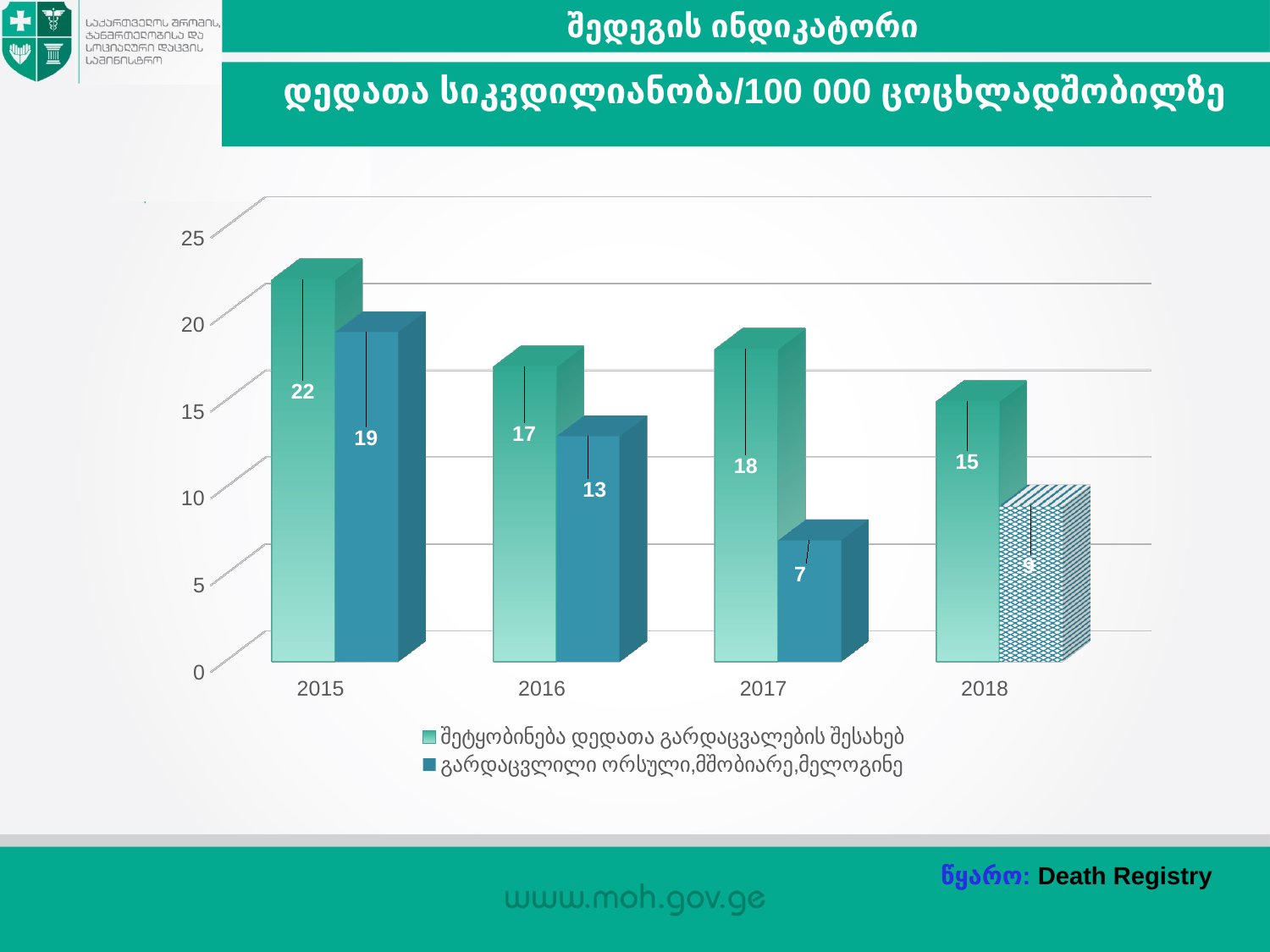
How many series does the legend list? 2 What is the value of the second legend series (გარდაცვლილი ორსული, მშობიარე, მელოგინე) for 2017? 7 What is the value of the first legend series (შეტყობინება დედათა გარდაცვალების შესახებ) for 2018? 15 What is the source cited at the bottom of the slide? Death Registry In which year is the second legend series (გარდაცვლილი ორსული, მშობიარე, მელოგინე) lowest? 2017 Which is larger: the second series value in 2016 or the second series value in 2018? 2016 What is the value of the first legend series (შეტყობინება დედათა გარდაცვალების შესახებ) for 2015? 22 What kind of chart is shown on the slide? bar chart How many years are shown on the x axis? 4 In which year is the first legend series (შეტყობინება დედათა გარდაცვალების შესახებ) highest? 2015 What is the difference between the two series' values in 2017? 11 Is the value of the first legend series for 2016 greater or less than 20? less